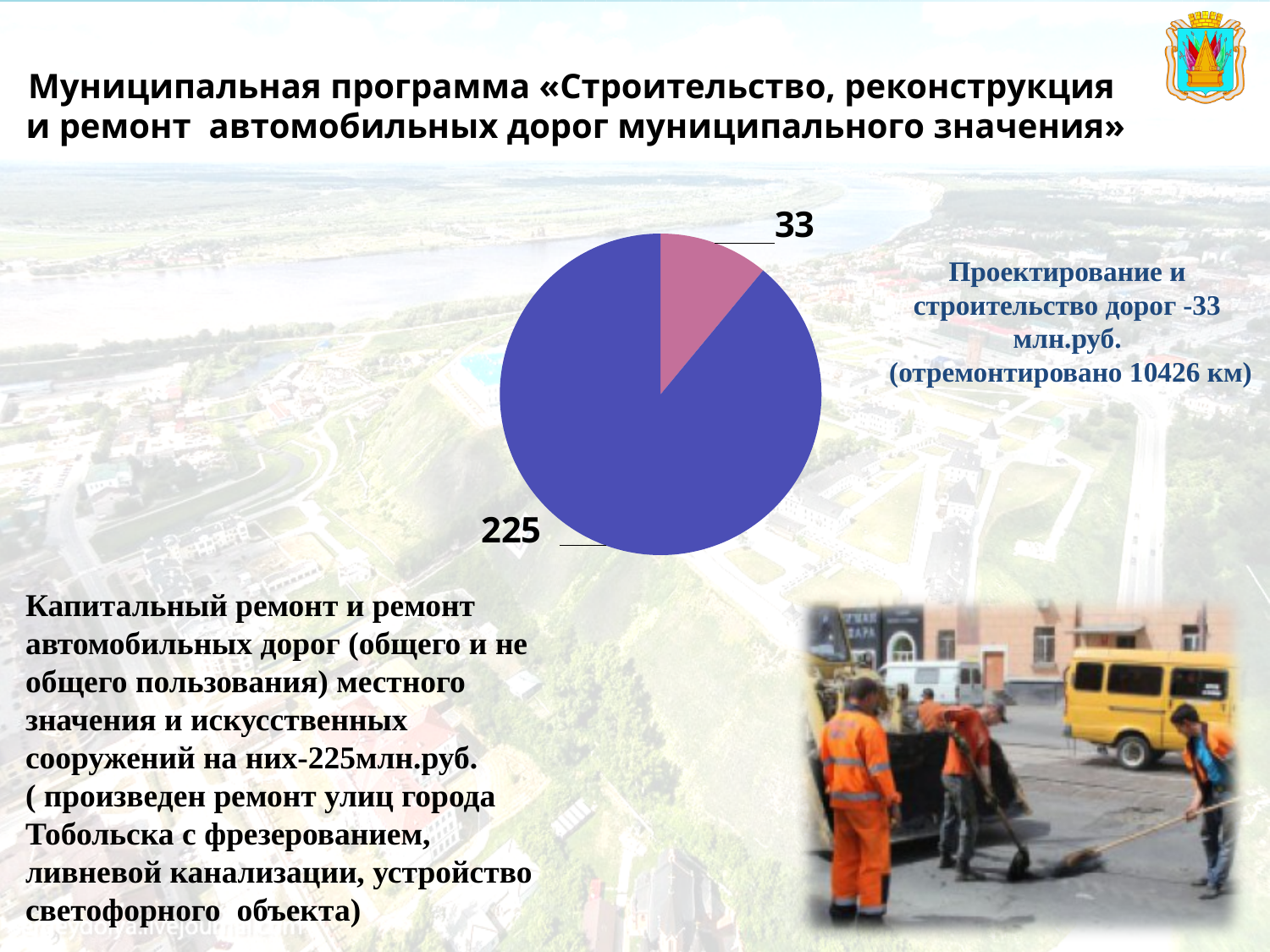
What is the difference between the two values shown in the pie chart, 225 and 33? 192 What is the smallest value shown in the pie chart? 33 Which slice is larger, the one labelled 225 or the one labelled 33? 225 What value is labelled on the small pink slice of the pie chart? 33 What value is labelled on the large blue slice of the pie chart? 225 What kind of chart is shown on the slide? pie chart What is the largest value shown in the pie chart? 225 What is the total of the two values shown in the pie chart? 258 How many slices does the pie chart have? 2 What colour is the slice labelled 33 in the pie chart? pink